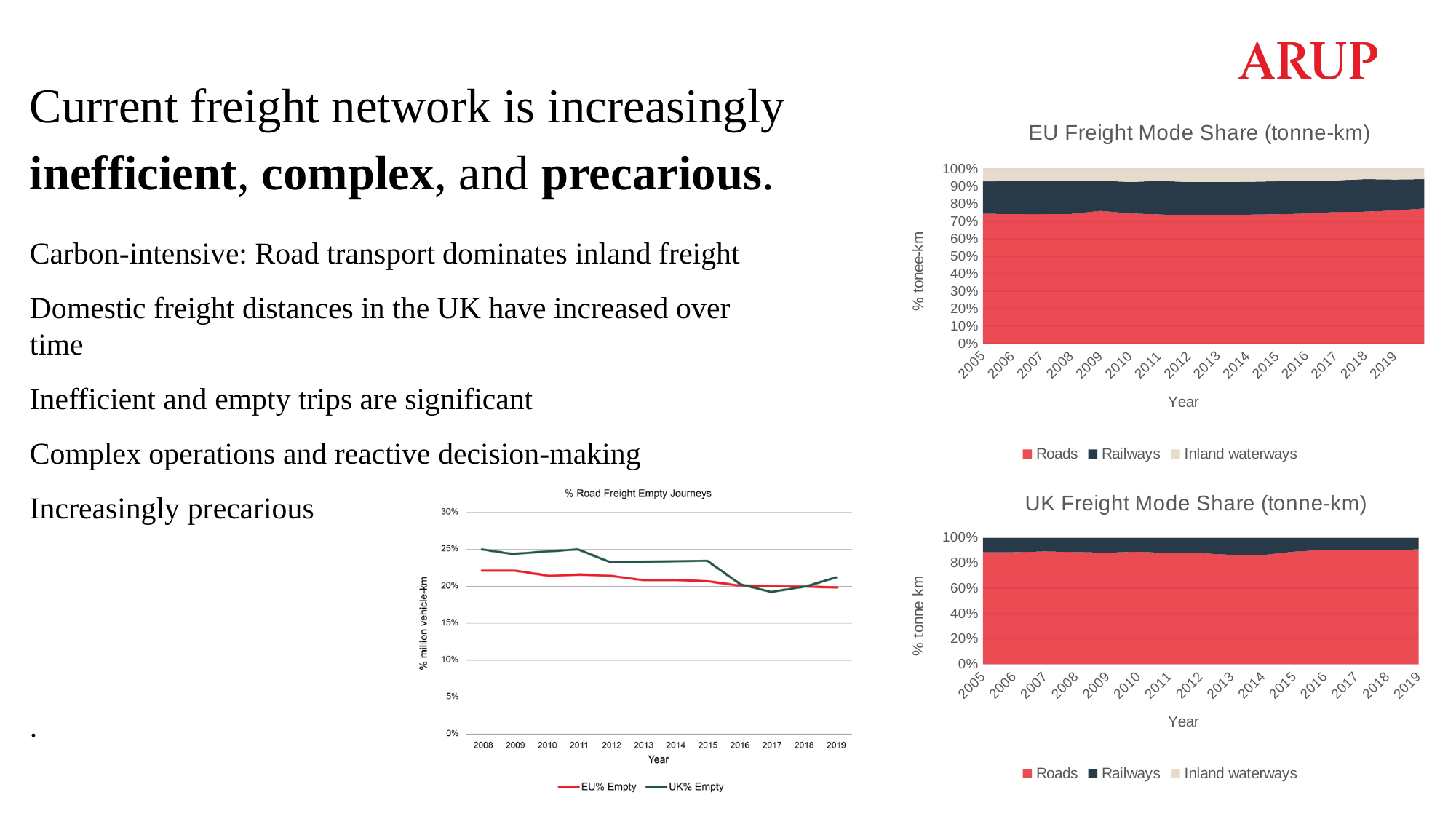
In the '% Road Freight Empty Journeys' chart, is the value for UK% Empty in 2008 greater or less than 20%? greater In the '% Road Freight Empty Journeys' chart, which series has the higher value in 2008, EU% Empty or UK% Empty? UK% Empty In the 'UK Freight Mode Share (tonne-km)' chart, is the Roads share in 2019 greater or less than 80%? greater In the '% Road Freight Empty Journeys' chart, does the EU% Empty series rise or fall from 2008 to 2019? fall In the 'EU Freight Mode Share (tonne-km)' chart, which series is shown in red? Roads What kind of chart is the 'EU Freight Mode Share (tonne-km)' chart? stacked area chart How many years are shown on the x axis of the 'UK Freight Mode Share (tonne-km)' chart? 15 What kind of chart is the '% Road Freight Empty Journeys' chart? line chart How many series does the legend of the 'EU Freight Mode Share (tonne-km)' chart list? 3 In the '% Road Freight Empty Journeys' chart, is the value for EU% Empty in 2019 greater or less than 25%? less How many years are shown on the x axis of the '% Road Freight Empty Journeys' chart? 12 How many series does the legend of the '% Road Freight Empty Journeys' chart list? 2